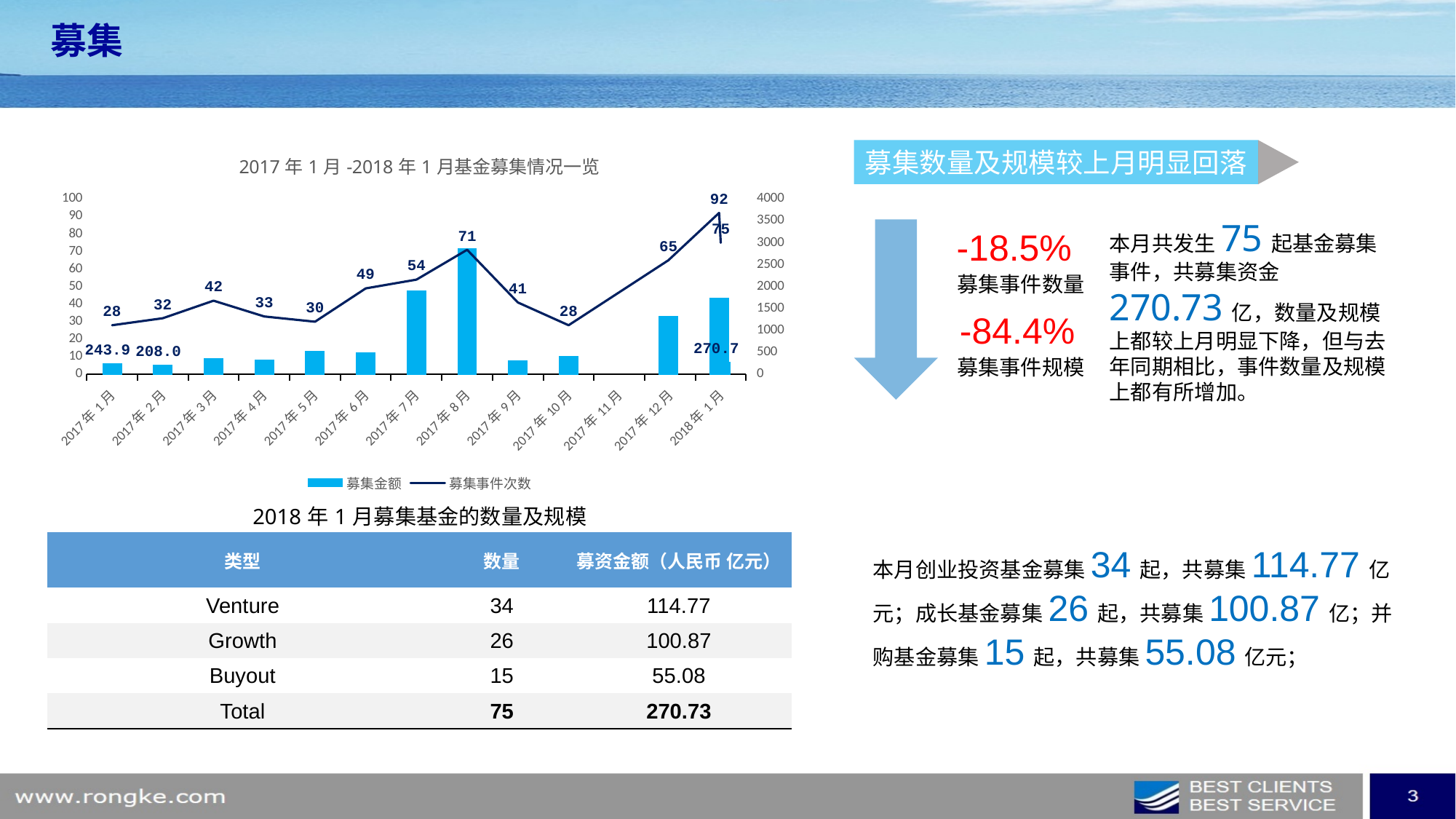
What is the difference in 募集事件次数 between 2017年8月 and 2017年7月? 17 Which month has a higher 募集事件次数, 2017年7月 or 2017年9月? 2017年7月 What kind of chart is shown on the slide? A combination chart with bars and a line How many series does the chart legend list? 2 What is the 募集金额 value labelled for 2017年1月? 243.9 Which month has the tallest 募集金额 bar? 2017年8月 What is the 募集事件次数 value for 2017年8月? 71 What is the 募集事件次数 value for 2017年3月? 42 How many months are shown on the x axis of the chart? 13 What is the title of the chart? 2017年1月-2018年1月基金募集情况一览 Is the 募集金额 bar for 2017年8月 greater or less than 2500 on the right axis? greater Does the 募集事件次数 line rise or fall from 2017年5月 to 2017年8月? rise